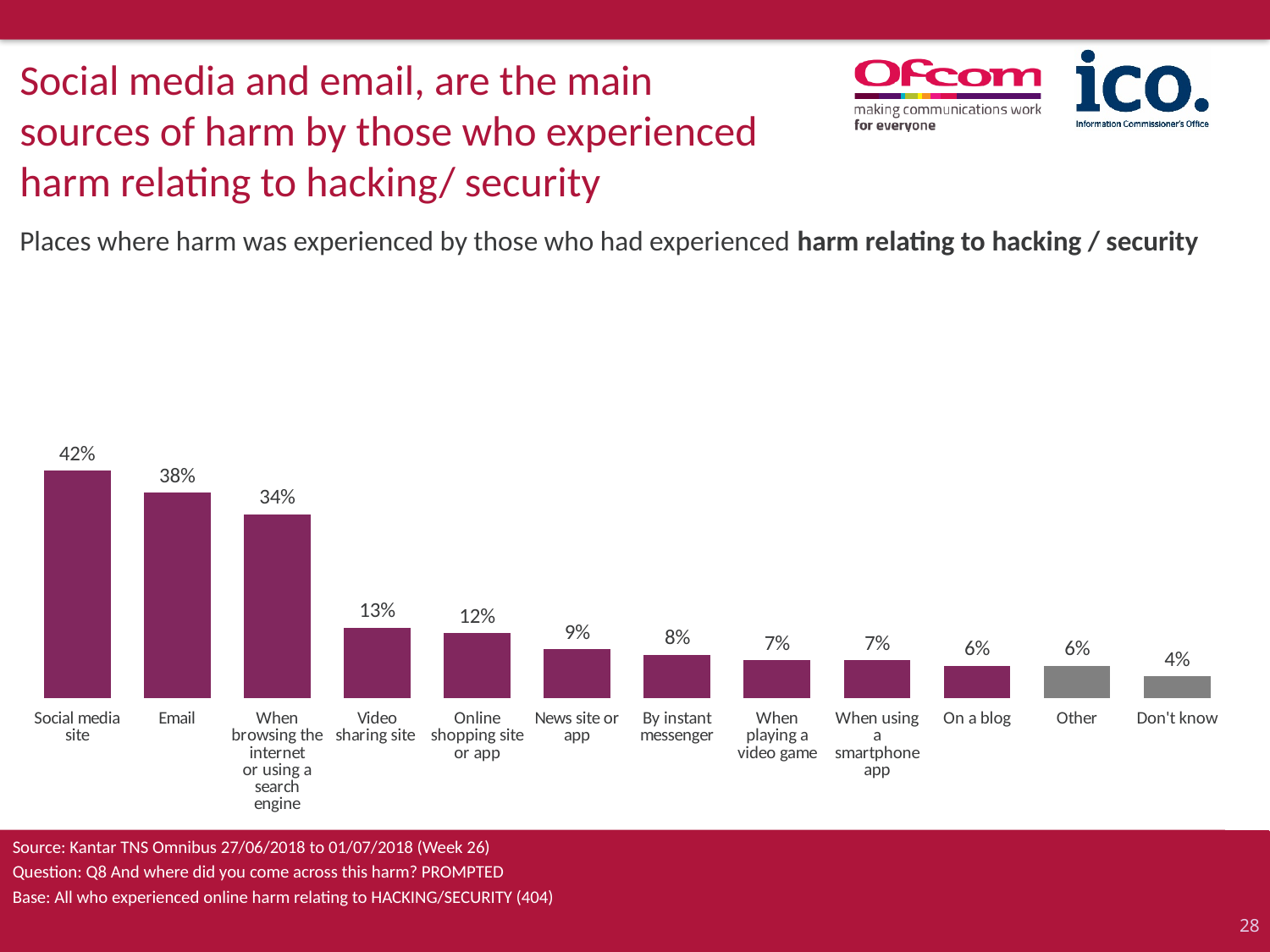
What is the value shown for Email? 38% Which category has the lowest value? Don't know How many categories are shown in the chart? 12 Which is larger, the value for Online shopping site or app or the value for By instant messenger? Online shopping site or app What percentage is shown for 'Don't know'? 4% What is the difference between the values for Social media site and Email? 4% What is the difference between the values for Video sharing site and News site or app? 4% Which category has the highest value? Social media site What is the value for 'When browsing the internet or using a search engine'? 34% What kind of chart is shown on the slide? Bar chart Which two categories are shown in grey rather than purple? Other and Don't know What percentage of respondents experienced harm relating to hacking/security on a social media site? 42%